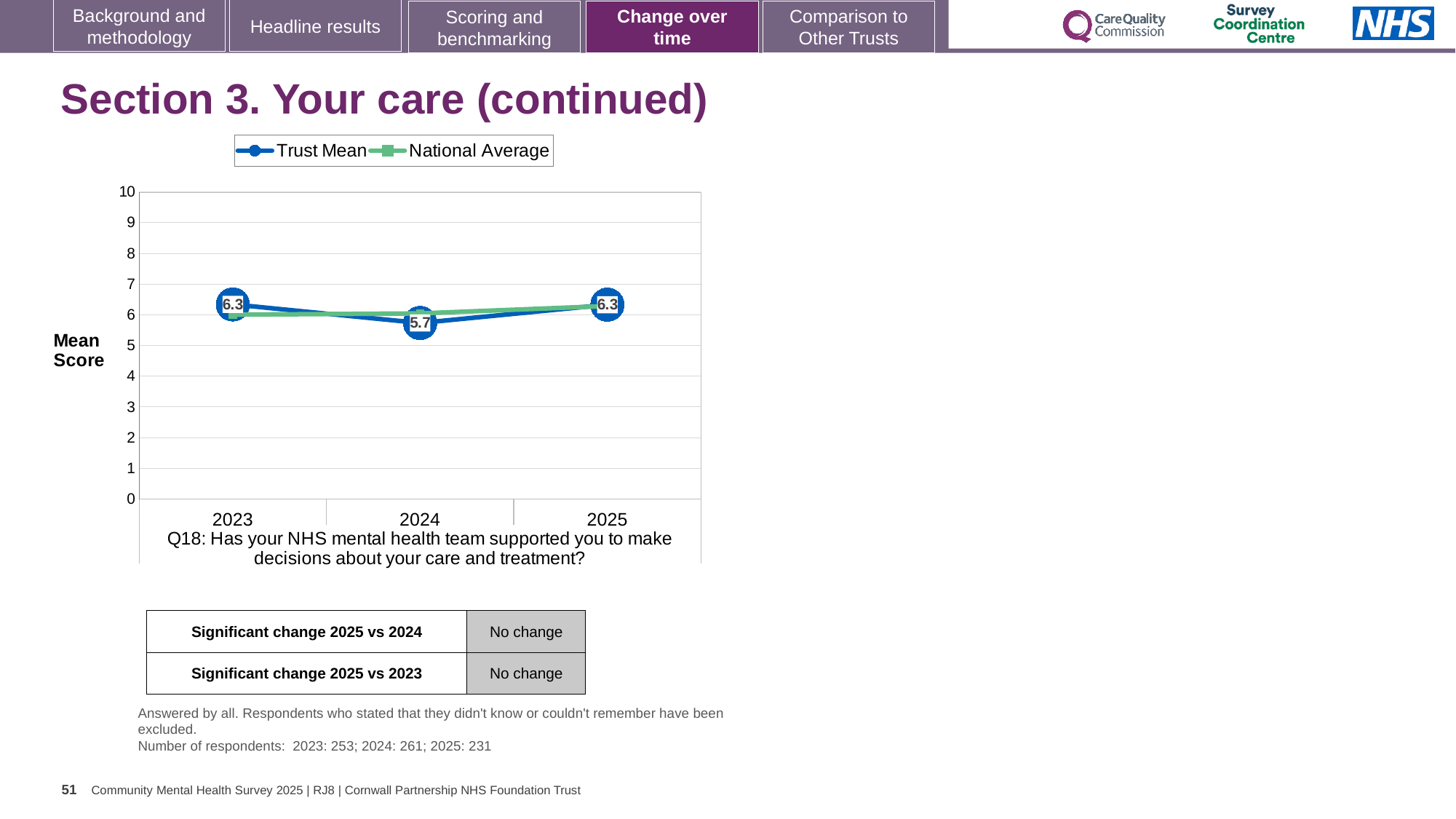
How many series does the chart legend list? 2 What is the Trust Mean score for 2023? 6.3 How many years are shown on the x axis of the chart? 3 What is the difference between the Trust Mean score in 2025 and in 2024? 0.6 What is the Trust Mean score for 2025? 6.3 What type of chart is shown on the slide? Line chart What is the Trust Mean score for 2024? 5.7 Is the National Average value for 2024 greater or less than 5? greater What is the label on the y axis of the chart? Mean Score In 2023, which is higher: the Trust Mean or the National Average? Trust Mean In which year is the Trust Mean score lowest? 2024 In 2024, which is higher: the Trust Mean or the National Average? National Average